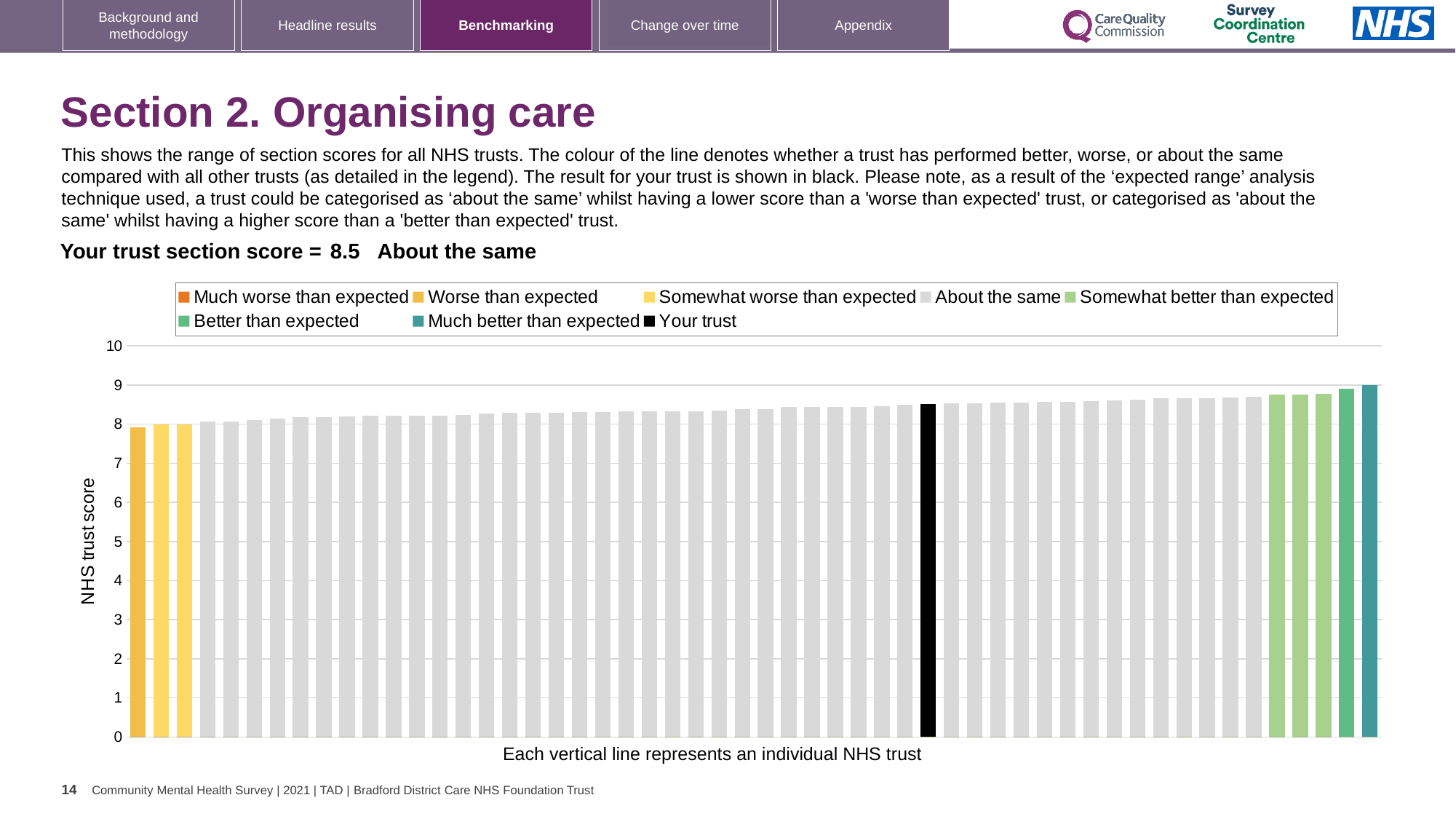
What is the section score for your trust? 8.5 What kind of chart is shown on the slide? bar chart What is the highest value shown on the y axis? 10 Is the value of the lowest bar greater or less than 7? greater How many entries does the chart legend list? 8 Is the value for your trust greater or less than 9? less Which benchmarking category is your trust placed in for this section? About the same Which legend category do the tallest bars on the right of the chart belong to? Much better than expected What colour is the bar representing your trust? black Is the value for your trust greater or less than 8? greater What is the label of the y axis? NHS trust score Do the bar values rise or fall from left to right along the x axis? rise